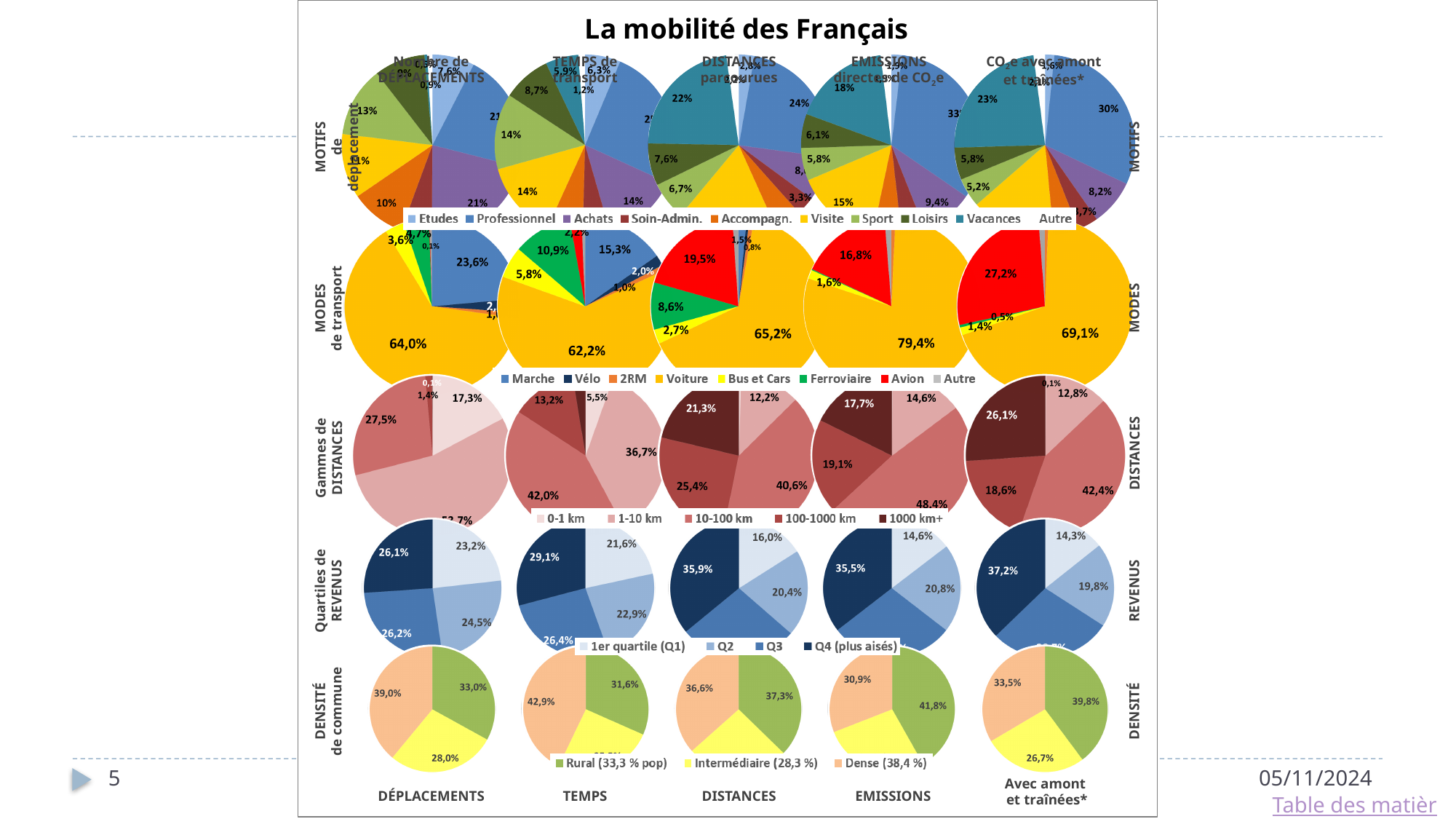
In the MODES de transport row, what share does Voiture have in the EMISSIONS pie chart? 79,4% In the DENSITÉ de commune row, what share does Rural have in the EMISSIONS pie chart? 41,8% In the MOTIFS de déplacement row, what share does Professionnel have in the 'Avec amont et traînées*' pie chart? 30% In the DENSITÉ de commune row, which category has the largest share in the DÉPLACEMENTS pie chart? Dense (38,4 %) In the MODES de transport row, what is the difference between the Voiture share in the EMISSIONS pie and the Voiture share in the DÉPLACEMENTS pie? 15,4% In the Quartiles de REVENUS row, is the Q4 (plus aisés) share larger in the TEMPS pie or in the 'Avec amont et traînées*' pie? Avec amont et traînées* What type of charts are shown on the slide? Pie charts How many entries does the legend for the MODES de transport row list? 8 In the Gammes de DISTANCES row, which range has the largest share in the TEMPS pie chart? 10-100 km In the MODES de transport row, what share does Avion have in the 'Avec amont et traînées*' pie chart? 27,2% In the Gammes de DISTANCES row, what share does the 1-10 km range have in the DÉPLACEMENTS pie chart? 52,7% In the Quartiles de REVENUS row, what share does Q4 (plus aisés) have in the DISTANCES pie chart? 35,9%